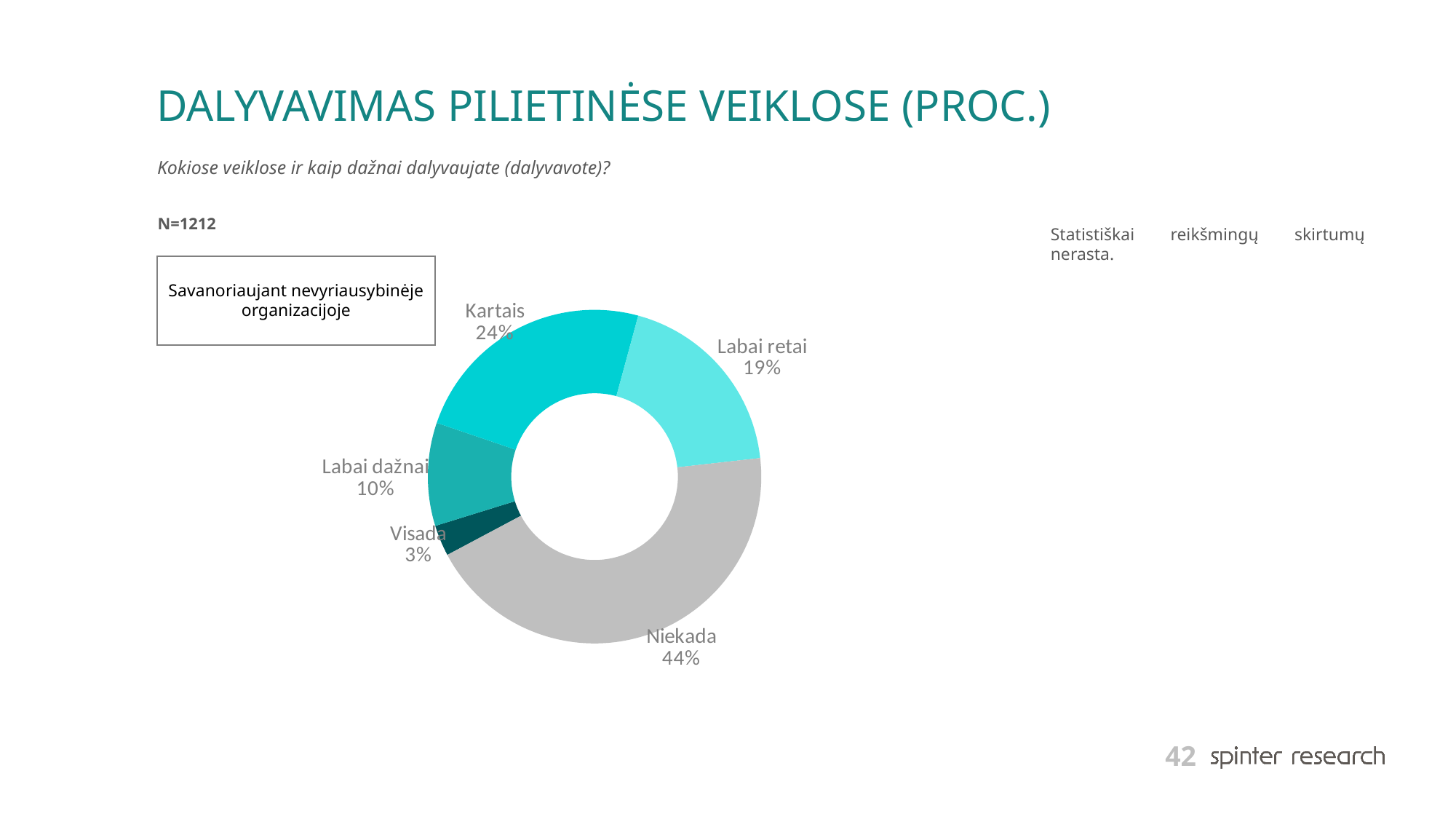
What is the sample size (N) stated on the slide? N=1212 What percentage of respondents answered "Labai retai"? 19% How many categories are shown in the chart? 5 Which category has the largest share of the chart? Niekada What percentage of respondents answered "Niekada"? 44% Which category has the smallest share of the chart? Visada What percentage of respondents answered "Kartais"? 24% What percentage of respondents answered "Visada"? 3% Which is larger, the share for "Kartais" or the share for "Labai retai"? Kartais What is the difference in percentage points between "Niekada" and "Kartais"? 20 What is the combined share of "Labai dažnai" and "Visada"? 13% What kind of chart is shown on the slide? Doughnut (pie) chart